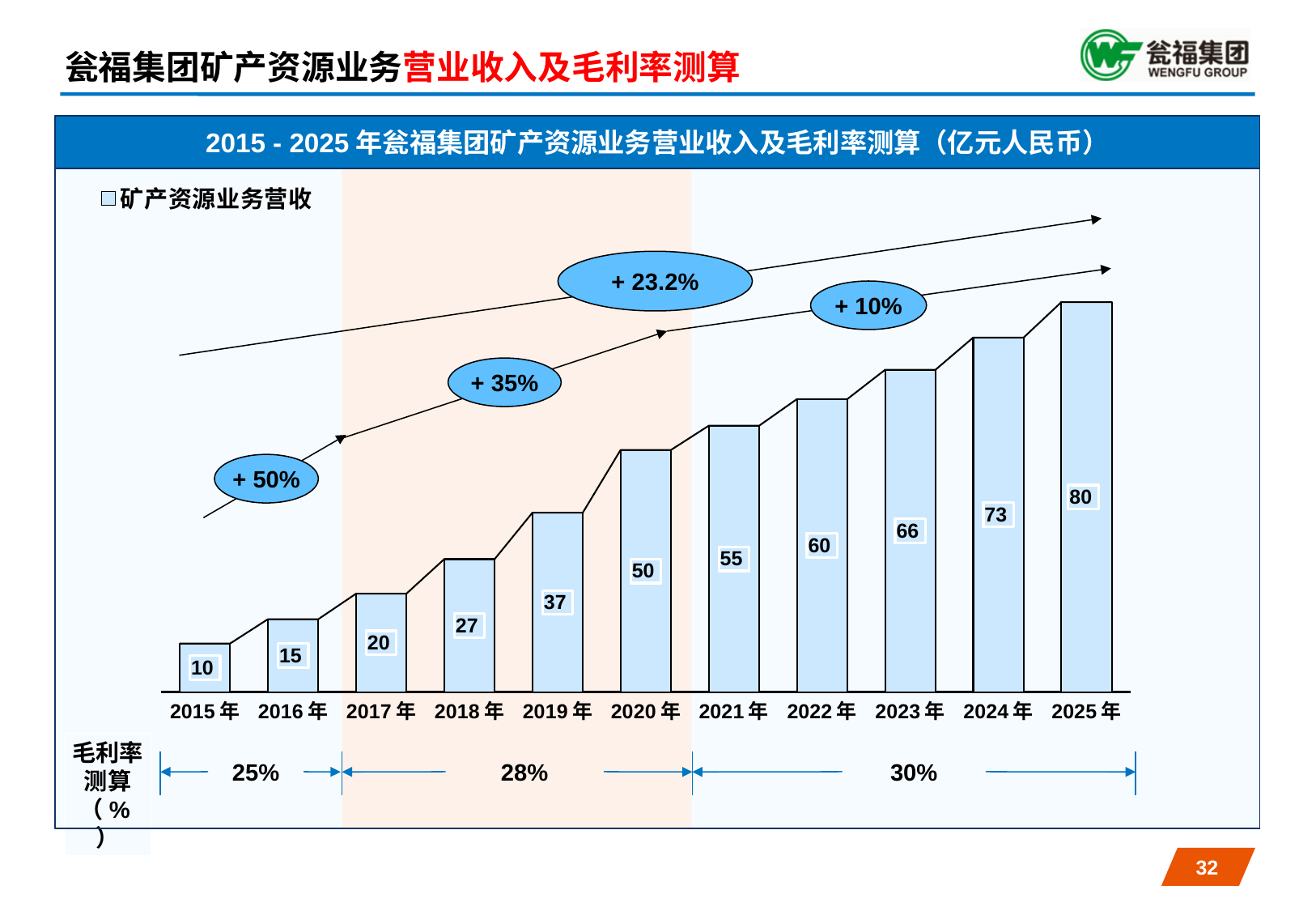
Do the values rise or fall from 2015年 to 2025年? rise What kind of chart is shown on the slide? bar chart What is the value for 2020年 in the chart? 50 Which year has the lowest value in the chart? 2015年 Which year has the highest value in the chart? 2025年 Which is larger, the value for 2018年 or the value for 2021年? 2021年 What is the difference between the values for 2020年 and 2019年? 13 What is the legend entry shown in the chart? 矿产资源业务营收 What is the difference between the values for 2025年 and 2015年? 70 What is the value for 2015年 in the chart? 10 What is the value for 2023年 in the chart? 66 How many years are shown on the x axis of the chart? 11